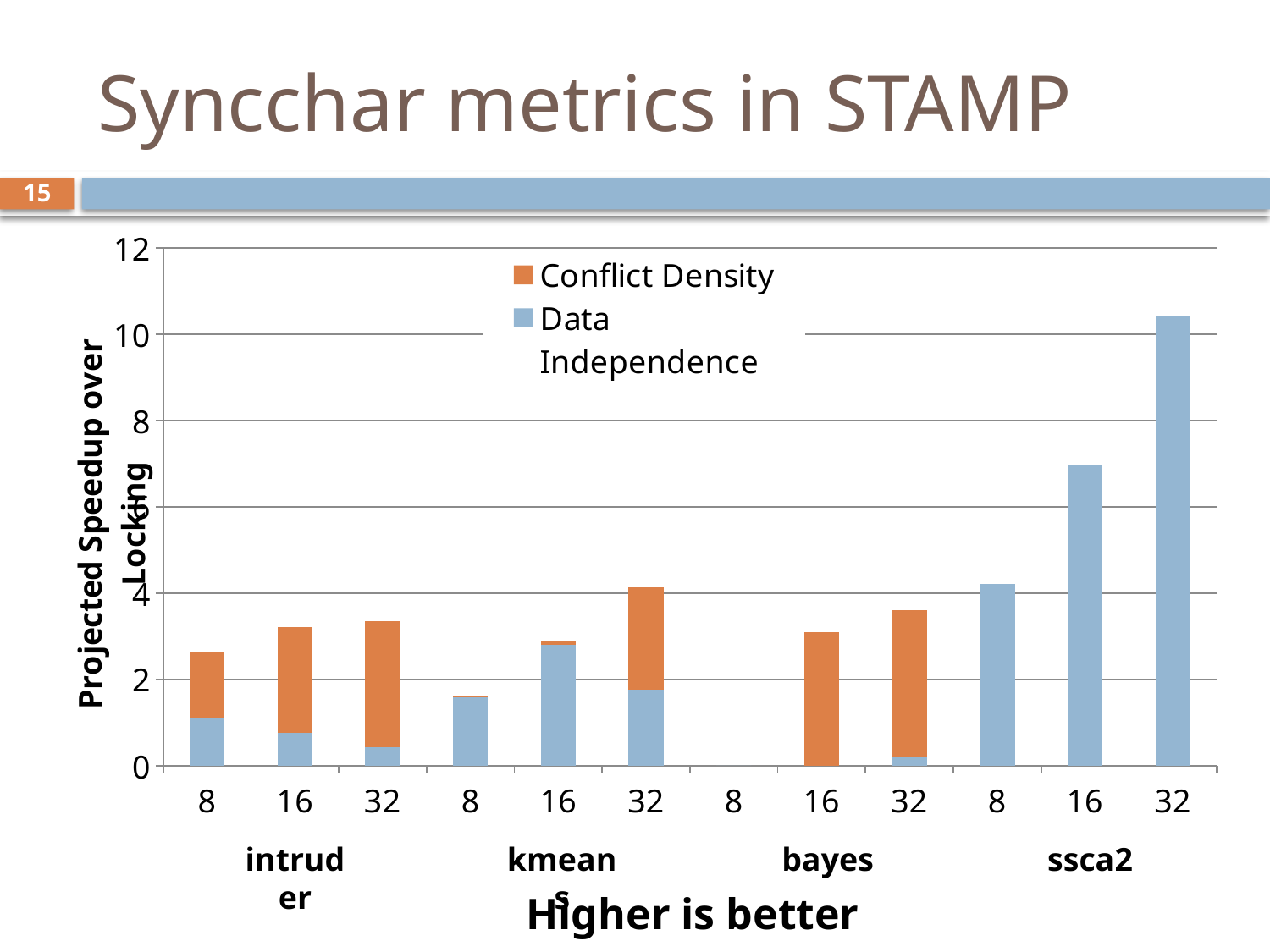
Which is taller, the bar for ssca2 at 16 or the bar for ssca2 at 32? ssca2 at 32 Is the value for kmeans at 8 greater or less than 2? less How many series does the legend list? 2 Is the value for ssca2 at 16 greater or less than 8? less How many benchmark groups are labelled along the x axis? 4 Within the ssca2 group, do the bars rise or fall as the thread count goes from 8 to 32? rise Which bar is the tallest in the chart? ssca2 at 32 Which is taller, the bar for kmeans at 8 or the bar for kmeans at 32? kmeans at 32 Is the value for ssca2 at 32 greater or less than 10? greater What is the title of the y axis? Projected Speedup over Locking What kind of chart is shown on the slide? Stacked bar chart